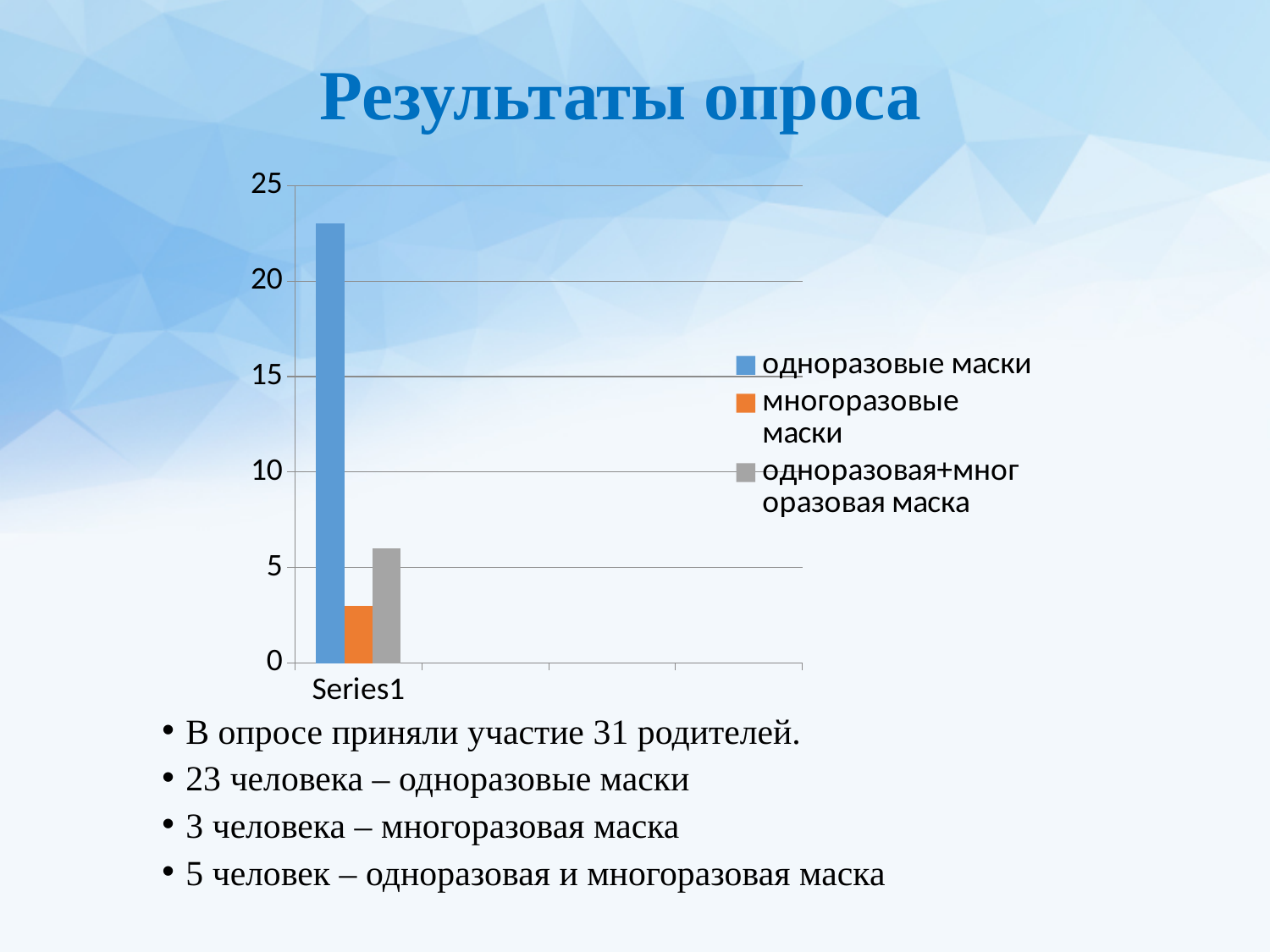
Which series has the highest bar? одноразовые маски How many categories are shown on the x axis? 1 What kind of chart is shown on the slide? bar chart Is the value for одноразовая+многоразовая маска greater or less than 10? less Is the value for многоразовые маски greater or less than 5? less Which is larger, the bar for одноразовая+многоразовая маска or the bar for многоразовые маски? одноразовая+многоразовая маска What colour is the bar for многоразовые маски? orange How many series does the legend list? 3 Which is larger, the bar for одноразовые маски or the bar for одноразовая+многоразовая маска? одноразовые маски Which series has the lowest bar? многоразовые маски What is the title of the slide above the chart? Результаты опроса Is the value for одноразовые маски greater or less than 20? greater